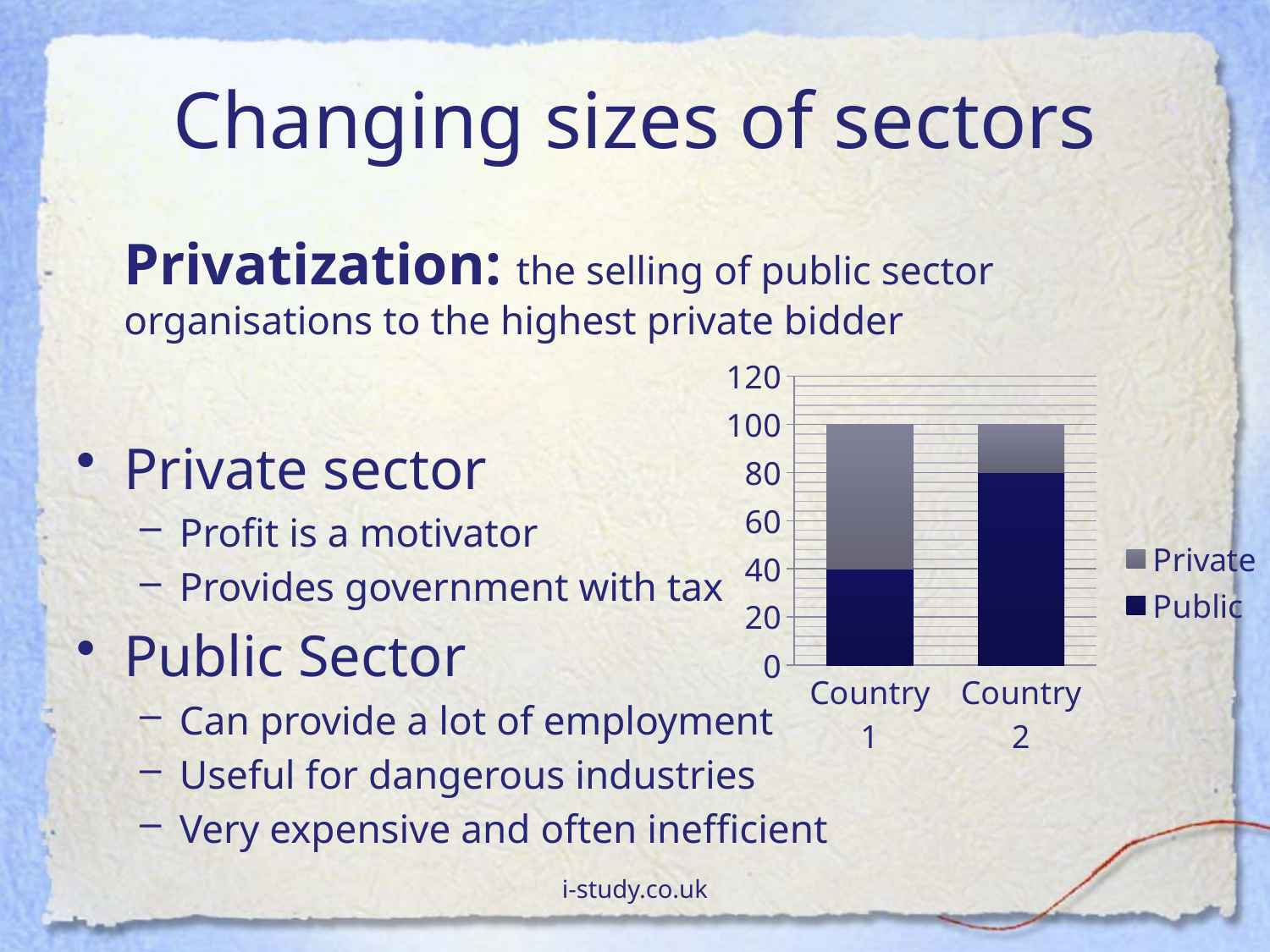
What is the total height of the stacked bar for Country 2? 100 Which series is shown in dark blue in the chart? Public Is the Private value for Country 2 greater or less than 40? less How many series does the chart legend list? 2 Which country has the larger Public value? Country 2 Which country has the larger Private value? Country 1 Is the Private value for Country 1 greater or less than 40? greater What is the Public value for Country 2? 80 What kind of chart is shown on the slide? Stacked bar chart How many categories are shown on the x axis of the chart? 2 What is the total height of the stacked bar for Country 1? 100 What is the Public value for Country 1? 40